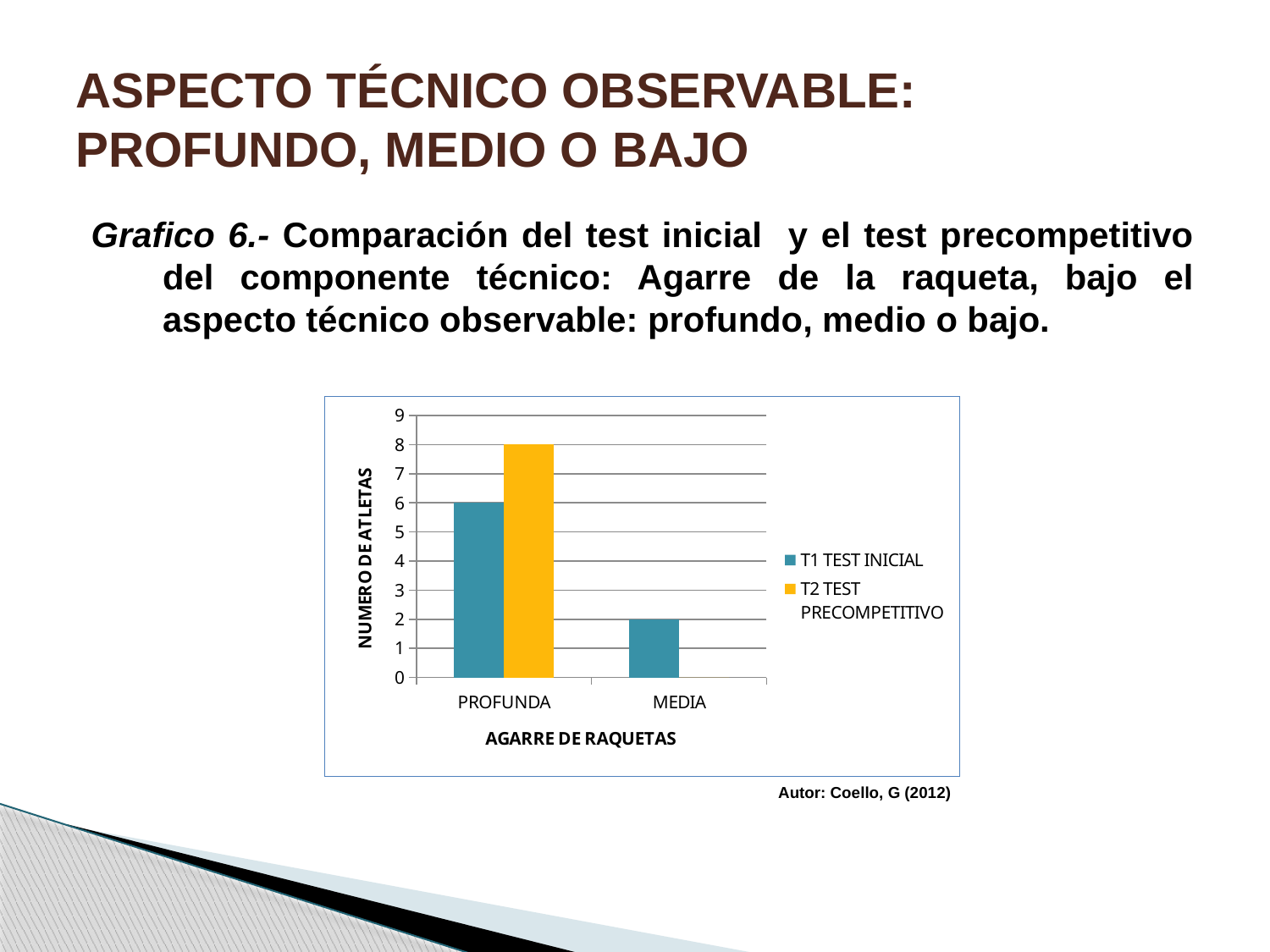
What is the value of T1 TEST INICIAL for MEDIA? 2 Which category has the highest T1 TEST INICIAL value? PROFUNDA What is the difference between T2 TEST PRECOMPETITIVO and T1 TEST INICIAL for PROFUNDA? 2 Which category has the lowest T1 TEST INICIAL value? MEDIA Is the T1 TEST INICIAL value for PROFUNDA greater or less than 5? greater What is the value of T1 TEST INICIAL for PROFUNDA? 6 What kind of chart is shown on the slide? bar chart How many series does the legend list? 2 For PROFUNDA, which series is larger: T1 TEST INICIAL or T2 TEST PRECOMPETITIVO? T2 TEST PRECOMPETITIVO What is the label of the y axis? NUMERO DE ATLETAS What is the value of T2 TEST PRECOMPETITIVO for PROFUNDA? 8 How many categories are shown on the x axis? 2